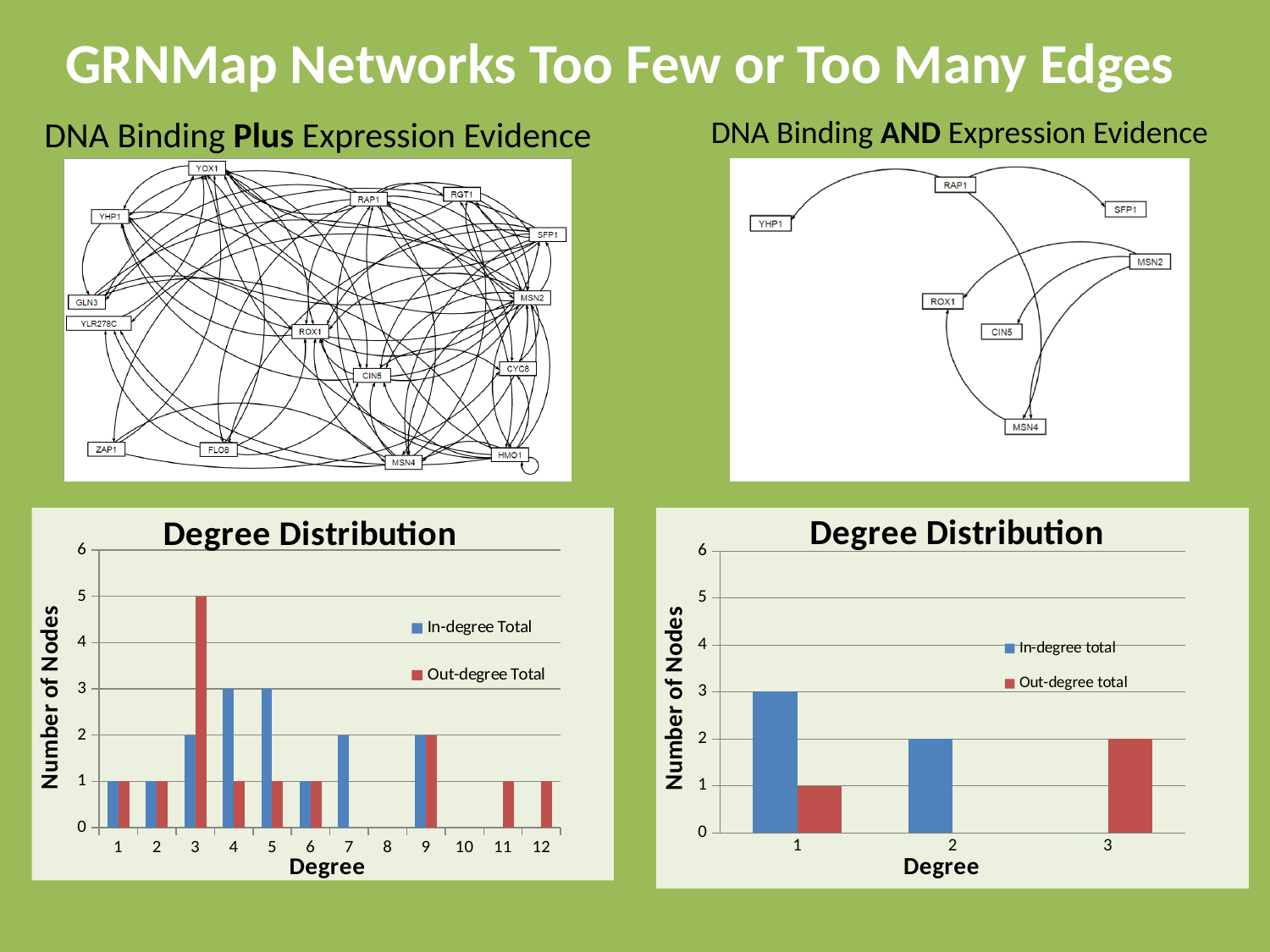
In the left Degree Distribution chart, how many series does the legend list? 2 In the right Degree Distribution chart, what is the In-degree total for degree 1? 3 In the left Degree Distribution chart, what is the Out-degree Total for degree 3? 5 In the left Degree Distribution chart, what is the In-degree Total for degree 7? 2 In the right Degree Distribution chart, what is the Out-degree total for degree 3? 2 In the left Degree Distribution chart, what is the In-degree Total for degree 4? 3 What kind of chart is the right Degree Distribution chart? Bar chart In the left Degree Distribution chart, which degree has the highest Out-degree Total? 3 In the left Degree Distribution chart, which is larger at degree 3, the In-degree Total or the Out-degree Total? Out-degree Total In the right Degree Distribution chart, what is the difference between the In-degree total and the Out-degree total at degree 1? 2 In the right Degree Distribution chart, how many degree categories are shown on the x axis? 3 In the left Degree Distribution chart, how many degree categories are shown on the x axis? 12